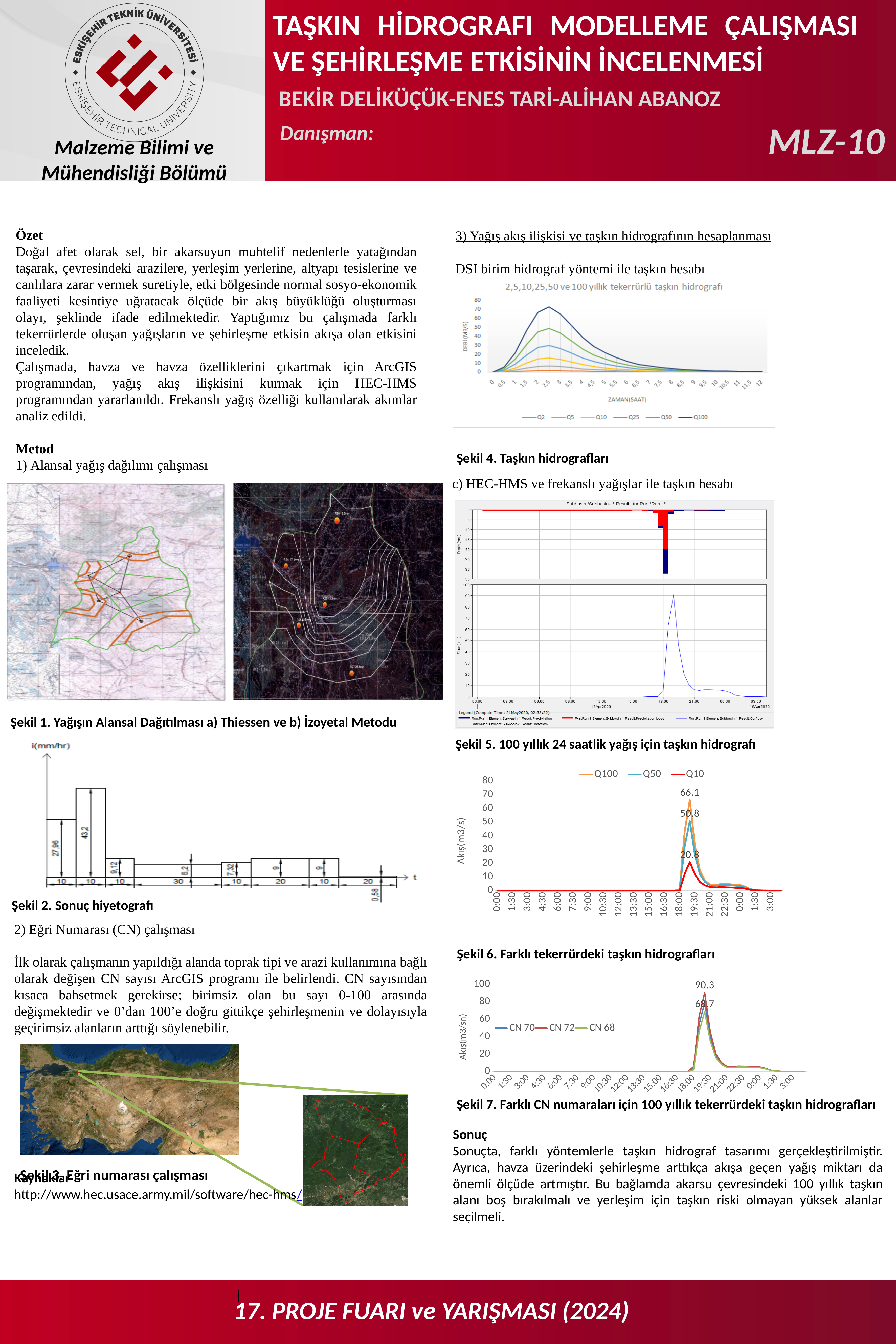
In the chart titled 'Şekil 6. Farklı tekerrürdeki taşkın hidrografları', which series has the lowest peak? Q10 In the chart titled 'Şekil 7. Farklı CN numaraları için 100 yıllık tekerrürdeki taşkın hidrografları', what is the highest peak value labelled? 90.3 In the chart titled 'Şekil 7. Farklı CN numaraları için 100 yıllık tekerrürdeki taşkın hidrografları', what is the label of the y axis? Akış(m3/sn) In the chart titled 'Şekil 6. Farklı tekerrürdeki taşkın hidrografları', is the peak value of the Q10 series greater or less than 30? less In the chart titled '2,5,10,25,50 ve 100 yıllık tekerrürlü taşkın hidrografı' (Şekil 4), how many series does the legend list? 6 In the chart titled 'Şekil 6. Farklı tekerrürdeki taşkın hidrografları', which series has the highest peak? Q100 In the chart titled 'Şekil 6. Farklı tekerrürdeki taşkın hidrografları', what is the difference between the labelled peak values of Q100 and Q50? 15.3 In the chart titled 'Şekil 6. Farklı tekerrürdeki taşkın hidrografları', what is the peak value labelled for the Q50 series? 50.8 In the chart titled 'Şekil 6. Farklı tekerrürdeki taşkın hidrografları', what is the peak value labelled for the Q100 series? 66.1 In the chart titled 'Şekil 7. Farklı CN numaraları için 100 yıllık tekerrürdeki taşkın hidrografları', how many series does the legend list? 3 In the chart titled 'Şekil 6. Farklı tekerrürdeki taşkın hidrografları', how many series does the legend list? 3 What kind of chart is 'Şekil 6. Farklı tekerrürdeki taşkın hidrografları'? line chart